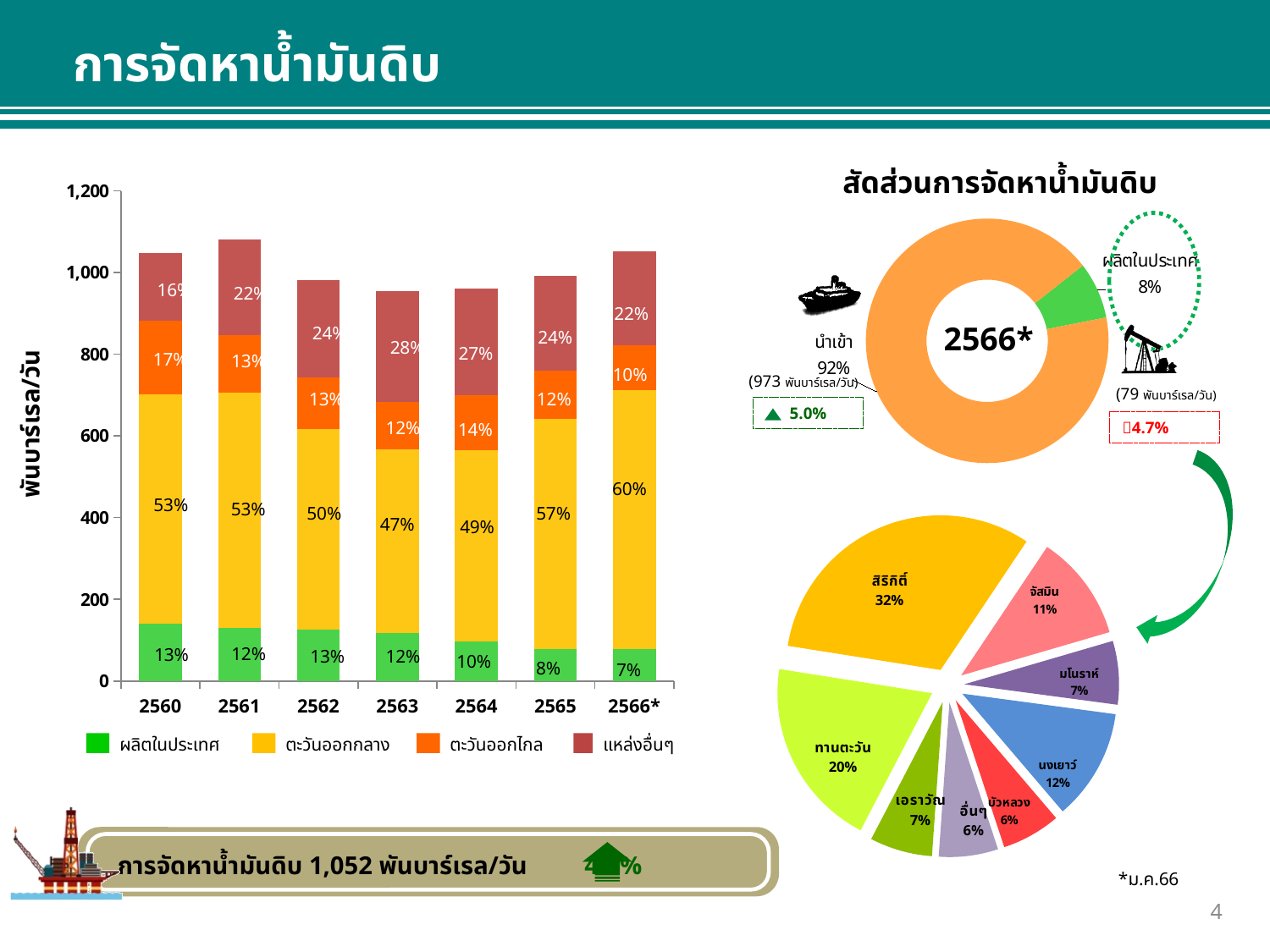
In the stacked bar chart on the left, is the ตะวันออกไกล share larger in 2560 or 2561? 2560 How many series does the legend of the stacked bar chart on the left list? 4 In the stacked bar chart on the left, by how many percentage points is the แหล่งอื่นๆ share in 2563 higher than in 2560? 12 percentage points In the stacked bar chart on the left, which year has the highest share for ตะวันออกกลาง? 2566* In the stacked bar chart on the left, is the total bar for 2563 greater or less than 1,000? less In the stacked bar chart on the left, what share does ตะวันออกกลาง have in 2566*? 60% In the stacked bar chart on the left, which year has the lowest share for ผลิตในประเทศ? 2566* How many years are shown on the x axis of the stacked bar chart on the left? 7 In the stacked bar chart on the left, does the ผลิตในประเทศ share rise or fall from 2560 to 2566*? fall In the pie chart at the bottom right, which field has the largest slice? สิริกิติ์ In the stacked bar chart on the left, what share does ผลิตในประเทศ have in 2560? 13% In the donut chart titled สัดส่วนการจัดหาน้ำมันดิบ, what share is นำเข้า? 92%